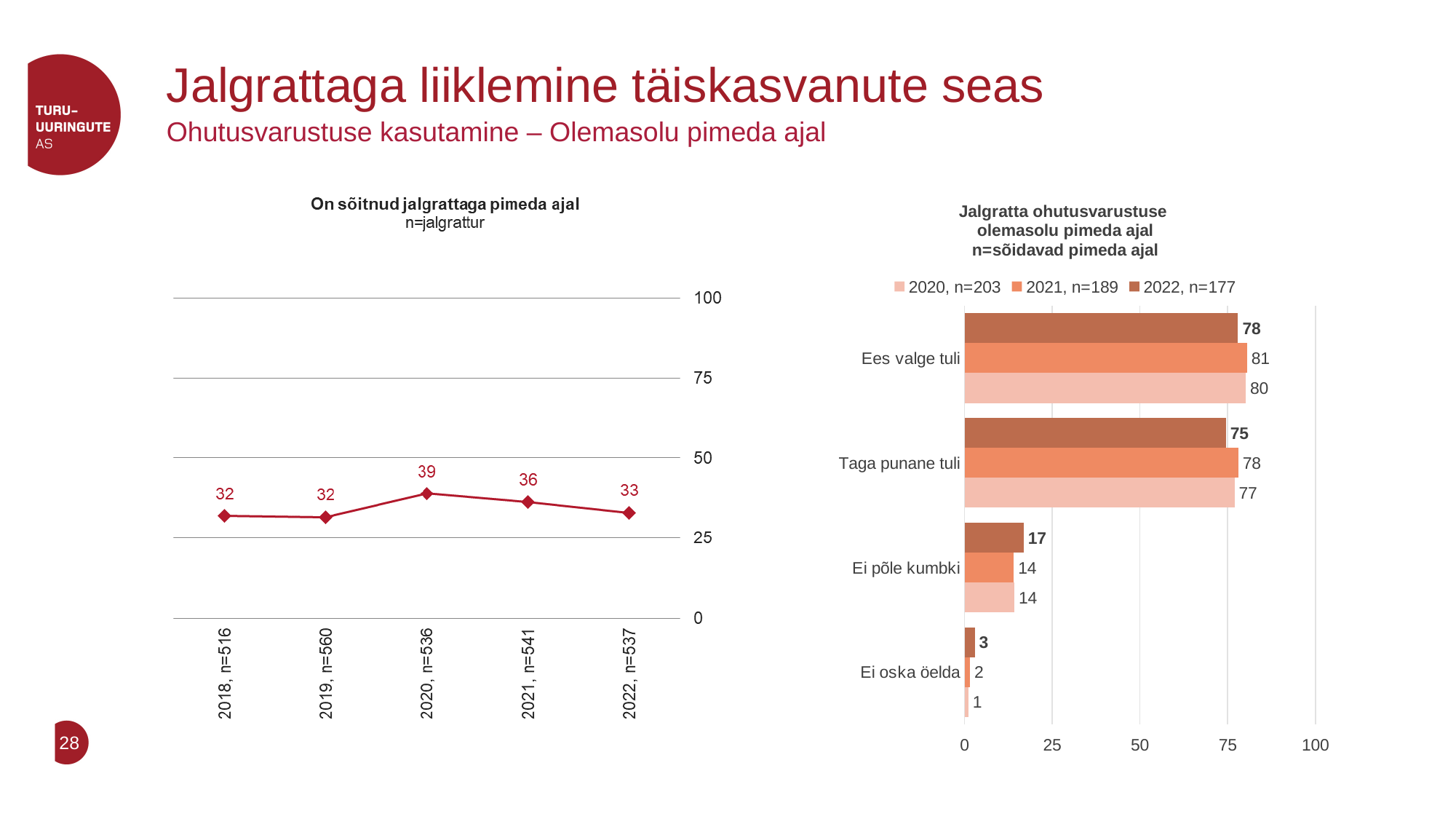
In the left chart 'On sõitnud jalgrattaga pimeda ajal', is the value for 2021 greater or less than 50? less In the left chart 'On sõitnud jalgrattaga pimeda ajal', which year has the highest value? 2020, n=536 In the left chart 'On sõitnud jalgrattaga pimeda ajal', how many data points are plotted? 5 In the right chart 'Jalgratta ohutusvarustuse olemasolu pimeda ajal', what is the value for 'Taga punane tuli' in the 2021, n=189 series? 78 In the left chart 'On sõitnud jalgrattaga pimeda ajal', what is the value for 2020, n=536? 39 In the right chart 'Jalgratta ohutusvarustuse olemasolu pimeda ajal', how many series does the legend list? 3 In the right chart 'Jalgratta ohutusvarustuse olemasolu pimeda ajal', what is the difference between the 2022 and 2021 values for 'Ei põle kumbki'? 3 In the right chart 'Jalgratta ohutusvarustuse olemasolu pimeda ajal', which category has the lowest value in the 2022, n=177 series? Ei oska öelda In the right chart 'Jalgratta ohutusvarustuse olemasolu pimeda ajal', which is larger for 'Ees valge tuli': the 2021, n=189 value or the 2022, n=177 value? 2021, n=189 What kind of chart is the right chart 'Jalgratta ohutusvarustuse olemasolu pimeda ajal'? bar chart In the left chart 'On sõitnud jalgrattaga pimeda ajal', what is the difference between the values for 2020 and 2022? 6 What kind of chart is the left chart 'On sõitnud jalgrattaga pimeda ajal'? line chart